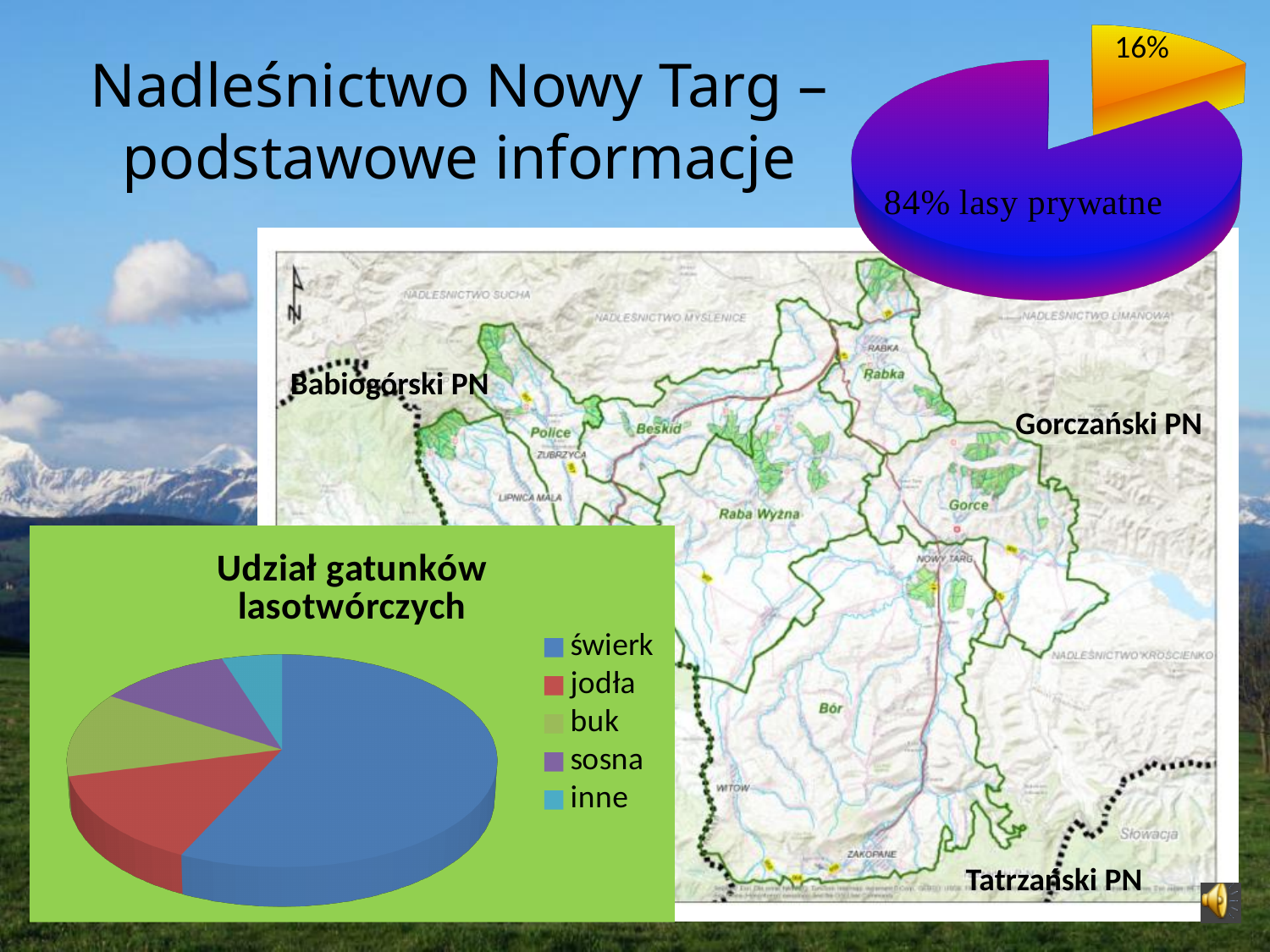
In 'Udział gatunków lasotwórczych', which slice is larger, świerk or jodła? świerk In 'Udział gatunków lasotwórczych', which species has the largest slice? świerk What kind of chart is the chart at the top right of the slide? pie chart In the pie chart at the top right of the slide, how many slices does the pie have? 2 In the pie chart at the top right of the slide, what share is labelled 'lasy prywatne'? 84% What kind of chart is 'Udział gatunków lasotwórczych'? pie chart In the pie chart at the top right of the slide, what percentage is shown on the smaller (yellow) slice? 16% How many entries does the legend of 'Udział gatunków lasotwórczych' list? 5 In the pie chart at the top right of the slide, which slice is larger, the one labelled 'lasy prywatne' or the yellow slice? lasy prywatne What is the title of the chart at the bottom left of the slide? Udział gatunków lasotwórczych In 'Udział gatunków lasotwórczych', which colour represents świerk in the legend? blue In the pie chart at the top right of the slide, what is the difference between the two slices' percentages? 68%